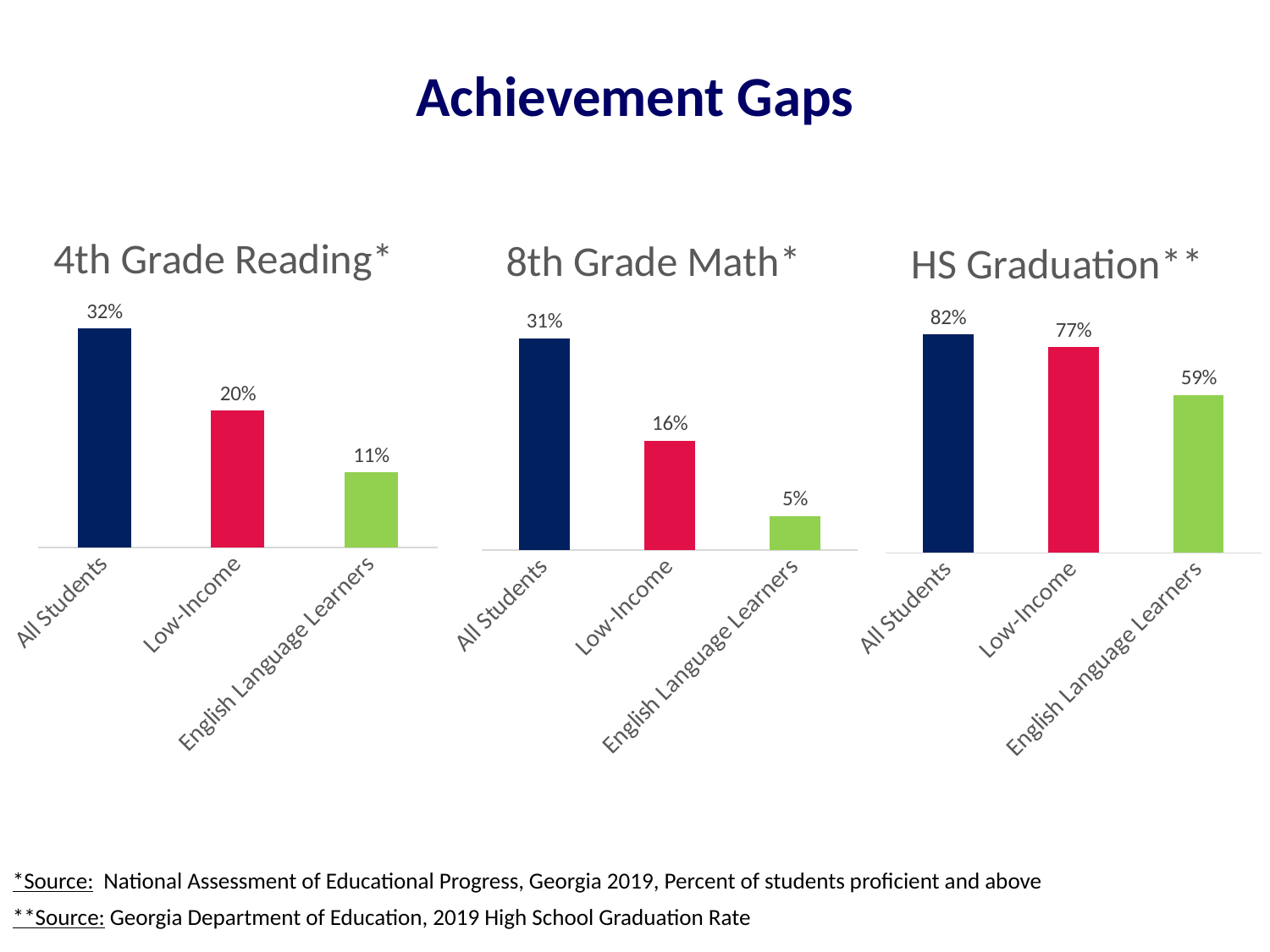
In the HS Graduation chart, what is the value for All Students? 82% How many categories are shown in the 8th Grade Math chart? 3 In the 4th Grade Reading chart, what is the value for Low-Income students? 20% How many charts are shown on the slide? 3 In the 4th Grade Reading chart, do the values rise or fall from left to right? Fall In the HS Graduation chart, what is the difference between All Students and Low-Income? 5% In the 4th Grade Reading chart, what is the difference between All Students and English Language Learners? 21% In the HS Graduation chart, which category has the lowest value? English Language Learners What type of chart is the HS Graduation chart? Bar chart In the 8th Grade Math chart, what is the value for English Language Learners? 5% Which is larger: the Low-Income value in the 4th Grade Reading chart or the Low-Income value in the 8th Grade Math chart? 4th Grade Reading In the 8th Grade Math chart, which category has the highest value? All Students